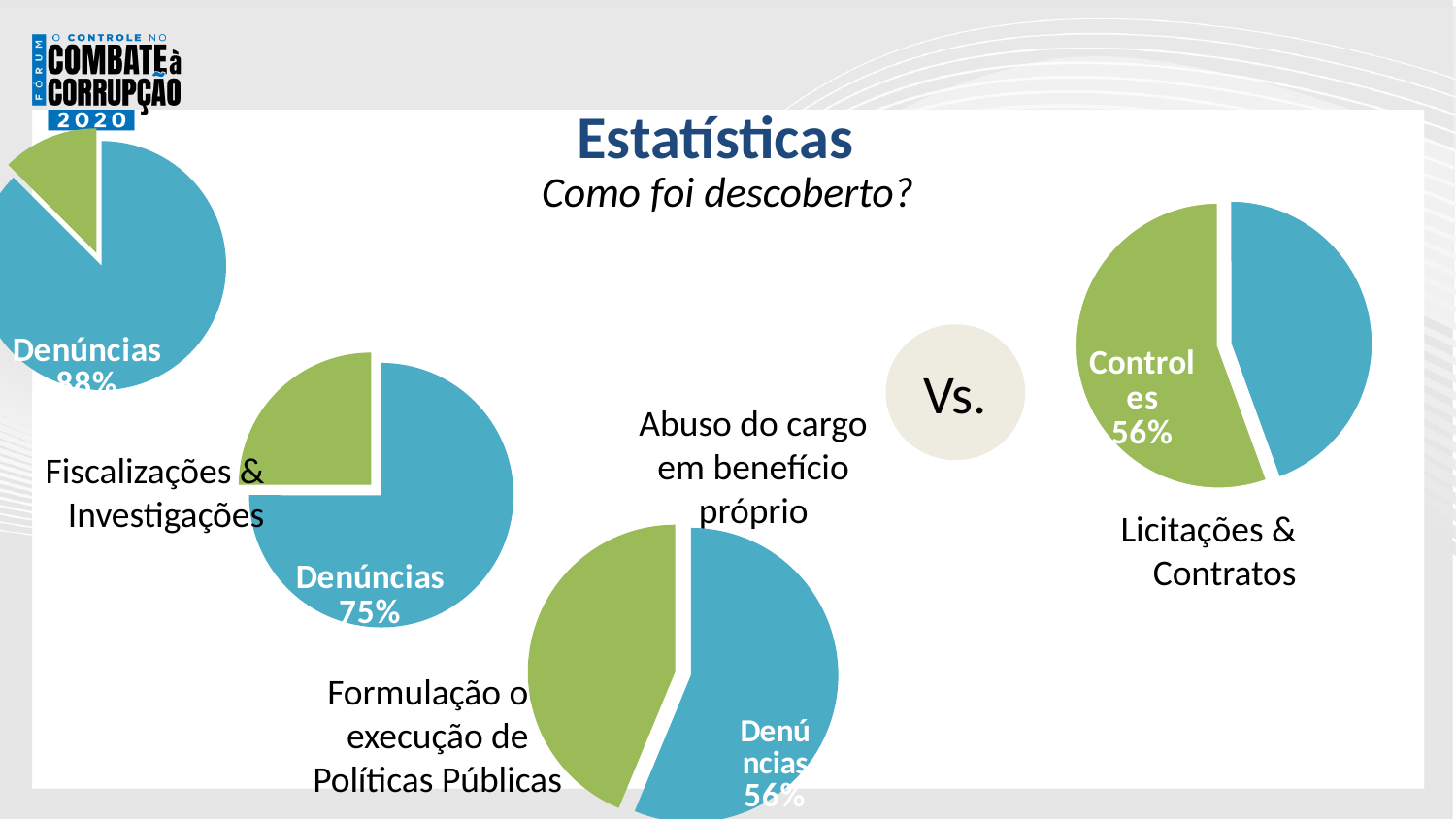
In the pie chart on the right, is the Controles slice greater or less than 50%? greater In the pie chart on the right of the slide, what share is labelled for Controles? 56% In the pie chart at the bottom centre of the slide, what share is labelled for Denúncias? 56% What kind of charts are shown on the slide? Pie charts In the second pie chart from the left (middle-left), what share is labelled for Denúncias? 75% How many pie charts are on the slide? 4 Which is larger: the Denúncias share in the middle-left pie chart or the Denúncias share in the bottom-centre pie chart? The middle-left pie chart (75%) What colour is the slice labelled Controles in the pie chart on the right? Green What is the difference between the Denúncias share in the middle-left pie chart (75%) and the Denúncias share in the bottom-centre pie chart (56%)? 19 percentage points In the middle-left pie chart, which slice is larger, the blue one or the green one? The blue one (Denúncias 75%) What is the main title of the slide? Estatísticas